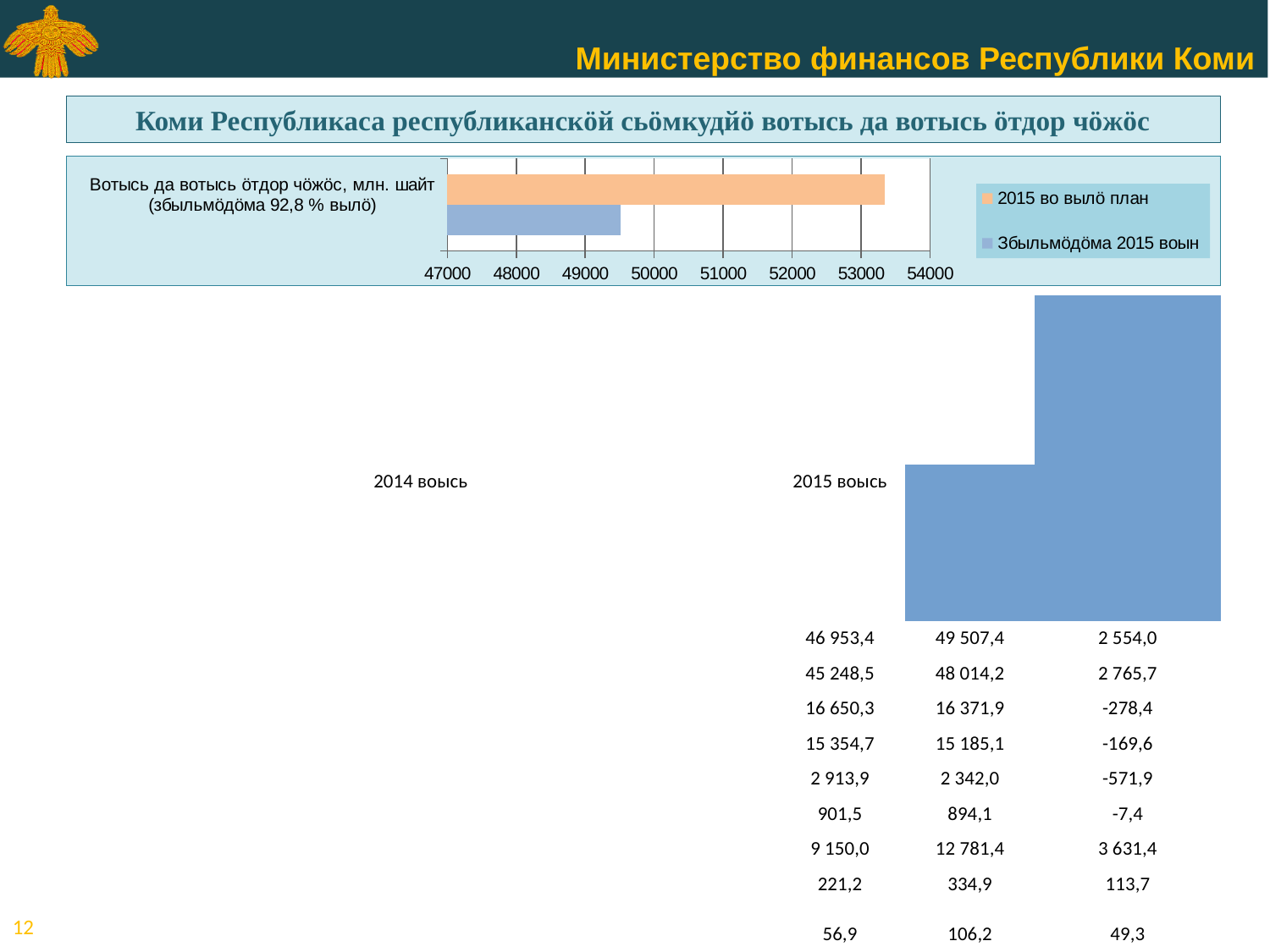
In the top chart, which series has the highest value? 2015 во вылö план In the top chart, how many categories are plotted on the vertical axis? 1 In the top chart, is the value for 'Збыльмöдöма 2015 воын' greater or less than 49000? greater In the top chart, what percentage is given in parentheses in the category label? 92,8 % What kind of chart is the top chart on the slide? bar chart In the top chart, which series has the lowest value? Збыльмöдöма 2015 воын In the top chart, is the value for '2015 во вылö план' greater or less than 53000? greater In the top chart, is the value for 'Збыльмöдöма 2015 воын' greater or less than 50000? less In the top chart, what is the lowest tick value shown on the horizontal axis? 47000 In the top chart, which series has the longer bar, '2015 во вылö план' or 'Збыльмöдöма 2015 воын'? 2015 во вылö план In the top chart, how many series does the legend list? 2 In the top chart, what are the two legend entries? 2015 во вылö план; Збыльмöдöма 2015 воын